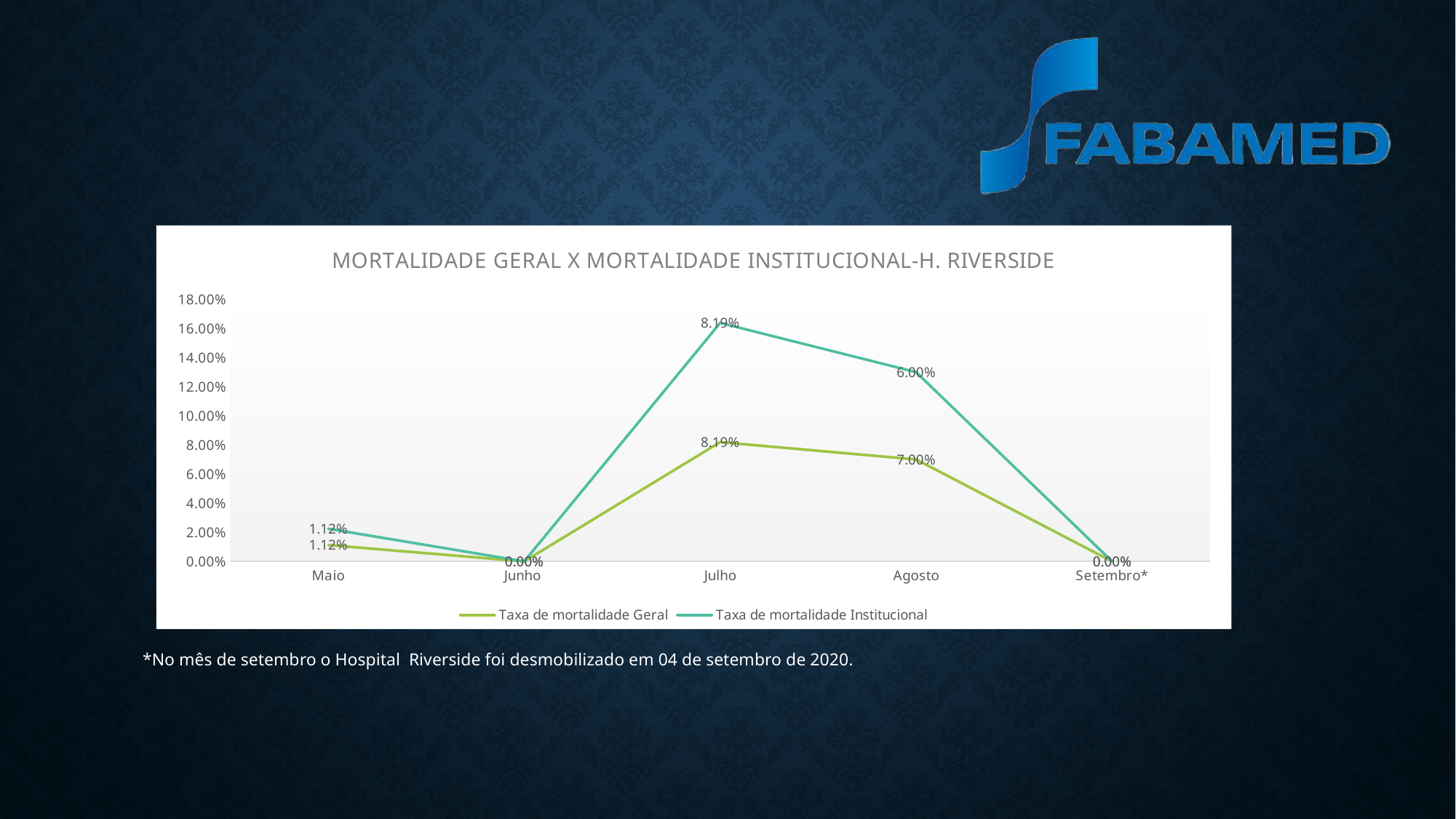
How many series does the legend list? 2 What is the title of the chart? MORTALIDADE GERAL X MORTALIDADE INSTITUCIONAL-H. RIVERSIDE What is the value of Taxa de mortalidade Geral in Agosto? 7.00% How many months are shown on the x axis? 5 What is the value of Taxa de mortalidade Geral in Maio? 1.12% In Julho, which series is higher: Taxa de mortalidade Geral or Taxa de mortalidade Institucional? Neither; both are 8.19% Does Taxa de mortalidade Geral rise or fall from Julho to Setembro*? fall What is the value of Taxa de mortalidade Geral in Junho? 0.00% What is the value of Taxa de mortalidade Geral in Julho? 8.19% In which month does Taxa de mortalidade Geral reach its highest value? Julho What kind of chart is shown on the slide? line chart